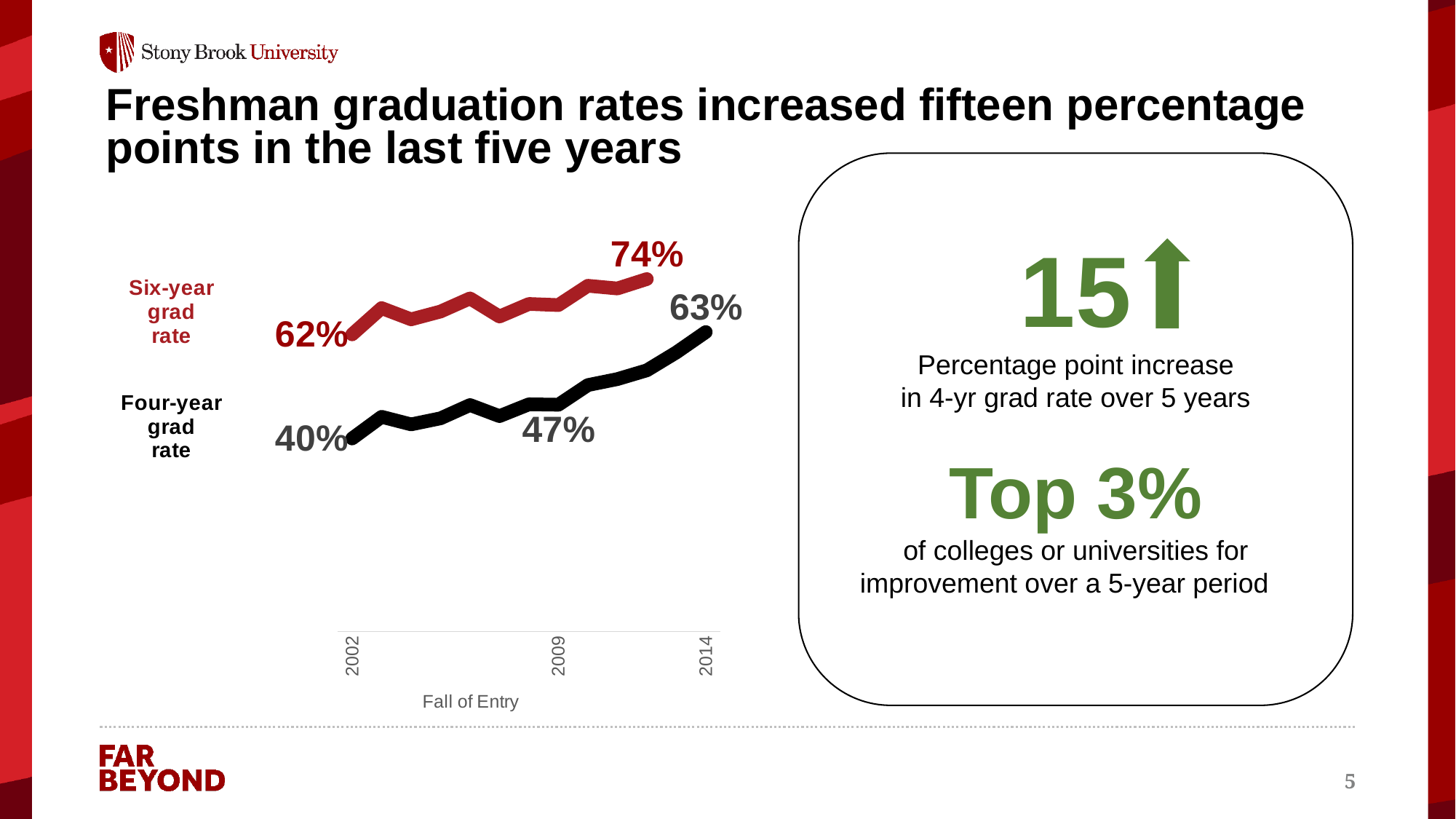
What was the four-year grad rate for the fall 2002 entry cohort? 40% Does the four-year grad rate generally rise or fall across the fall-of-entry years? rise By how many percentage points did the four-year grad rate rise from the 2002 cohort to the 2014 cohort? 23 percentage points What is the difference between the six-year grad rate and the four-year grad rate for the 2002 entry cohort? 22 percentage points What colour is the line for the six-year grad rate? red For the 2002 entry cohort, which was higher: the six-year grad rate or the four-year grad rate? Six-year grad rate How many series are plotted on the chart? 2 What was the four-year grad rate for the fall 2014 entry cohort? 63% What kind of chart is shown on the slide? line chart What was the six-year grad rate for the fall 2002 entry cohort? 62% What is the highest value labeled on the six-year grad rate line? 74% What is the title of the x axis? Fall of Entry